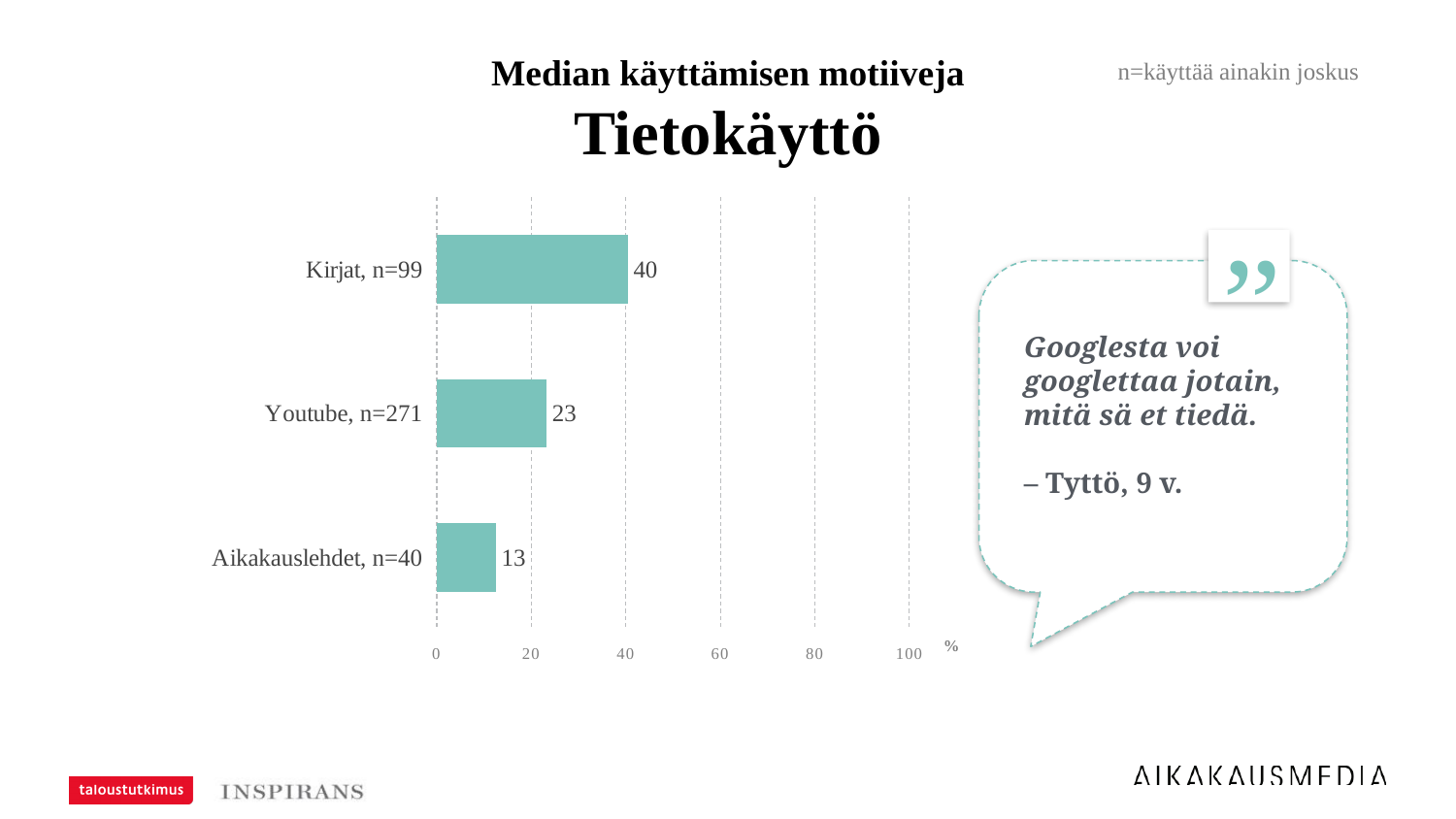
Which category has the lowest value? Aikakauslehdet, n=40 How many categories are shown in the chart? 3 What is the title of the chart? Median käyttämisen motiiveja Tietokäyttö What is the difference between the values for Kirjat, n=99 and Youtube, n=271? 17 What is the value for Kirjat, n=99? 40 What is the value for Aikakauslehdet, n=40? 13 Which category has the highest value? Kirjat, n=99 What kind of chart is shown on the slide? bar chart Which is larger, the value for Youtube, n=271 or the value for Aikakauslehdet, n=40? Youtube, n=271 What is the difference between the values for Youtube, n=271 and Aikakauslehdet, n=40? 10 What is the value for Youtube, n=271? 23 Is the value for Kirjat, n=99 greater or less than 60? less